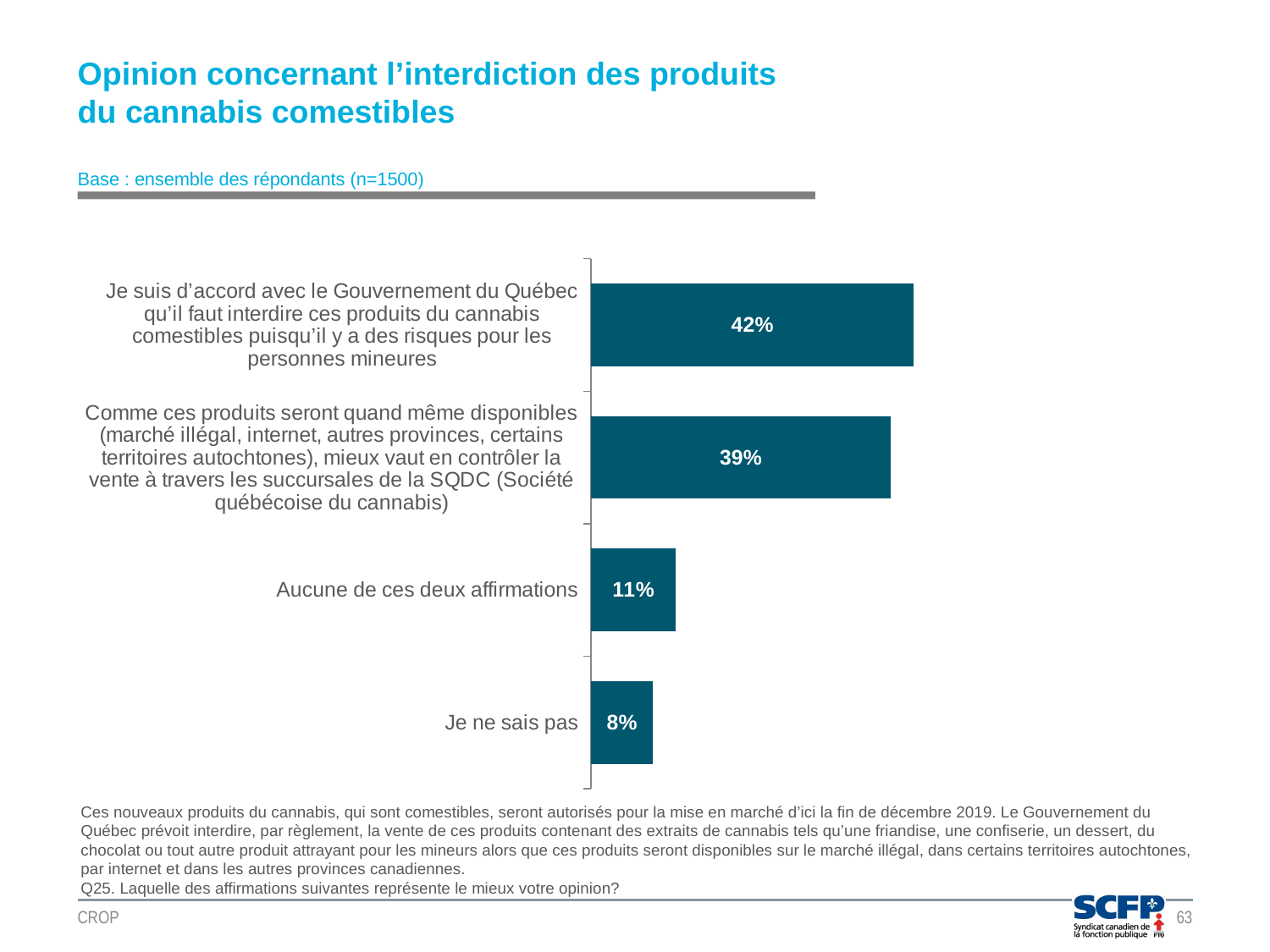
Which response option has the lowest percentage? Je ne sais pas What type of chart is shown on the slide? Bar chart What percentage of respondents chose "Aucune de ces deux affirmations"? 11% How many response categories are shown in the chart? 4 What percentage of respondents answered "Je ne sais pas"? 8% What is the base (number of respondents) indicated for this chart? n=1500 Which response option has the highest percentage? Je suis d'accord avec le Gouvernement du Québec qu'il faut interdire ces produits du cannabis comestibles puisqu'il y a des risques pour les personnes mineures What percentage of respondents agree with the Gouvernement du Québec that these edible cannabis products should be banned because of risks to minors? 42% What is the difference in percentage points between "Aucune de ces deux affirmations" and "Je ne sais pas"? 3 percentage points What percentage of respondents think it is better to control the sale of these products through SQDC stores since they will be available anyway? 39% What is the difference in percentage points between the option agreeing with the ban (42%) and the option favouring control through the SQDC (39%)? 3 percentage points Which is larger: the percentage for "Aucune de ces deux affirmations" or the percentage for "Je ne sais pas"? Aucune de ces deux affirmations